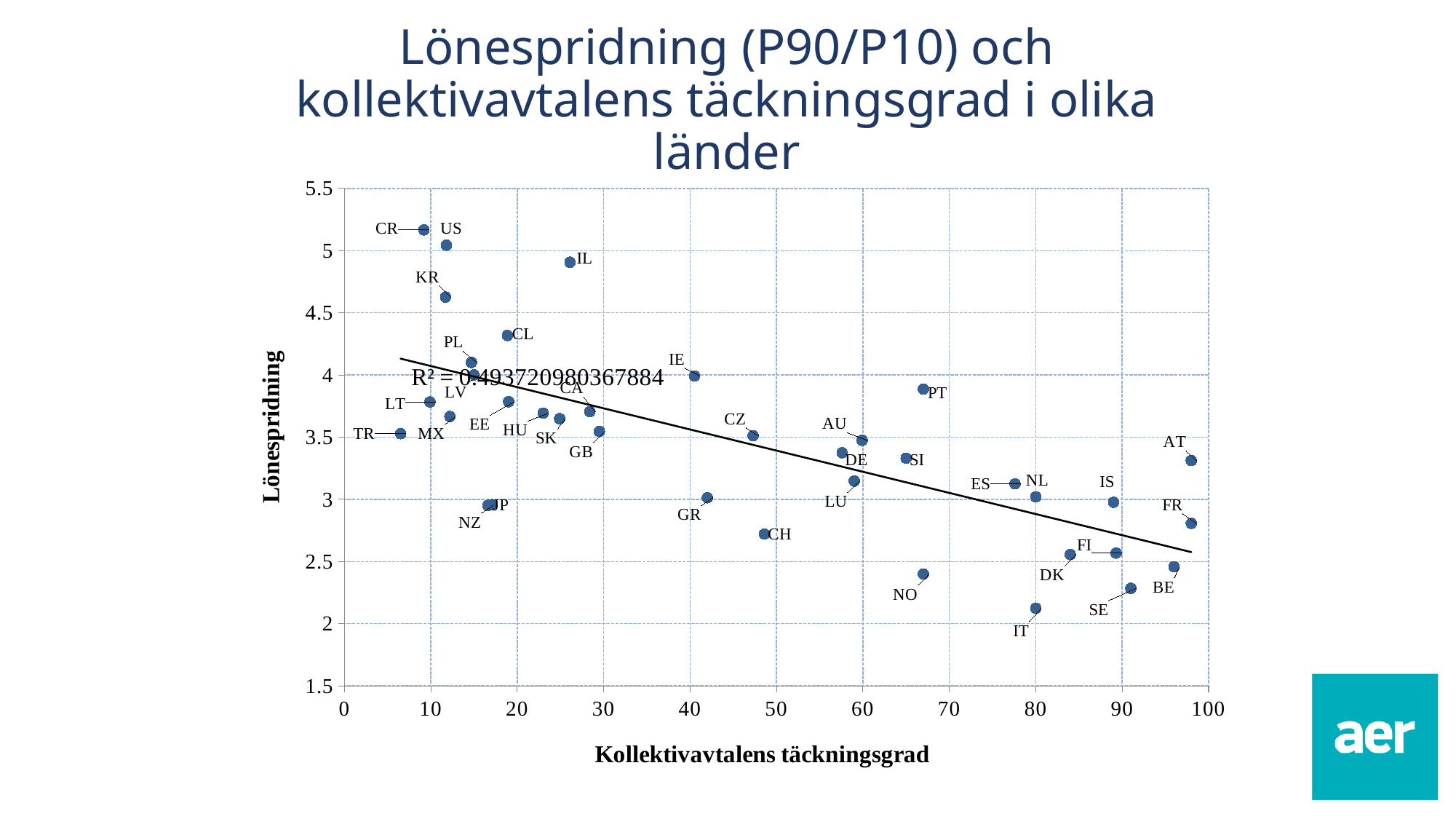
What kind of chart is shown on the slide? Scatter chart What R² value is printed on the chart? 0.493720980367884 Which has the higher Lönespridning, PT or NO? PT Which has the higher Lönespridning, AT or FR? AT Which country has the highest Lönespridning in the chart? CR Is the Lönespridning value for IL greater or less than 4.5? greater Is the Lönespridning value for CH greater or less than 3? less Which country has the lowest Lönespridning in the chart? IT Is the Lönespridning value for IT greater or less than 2.5? less As Kollektivavtalens täckningsgrad increases along the x axis, does Lönespridning generally rise or fall? Fall Which has the higher Lönespridning, US or KR? US